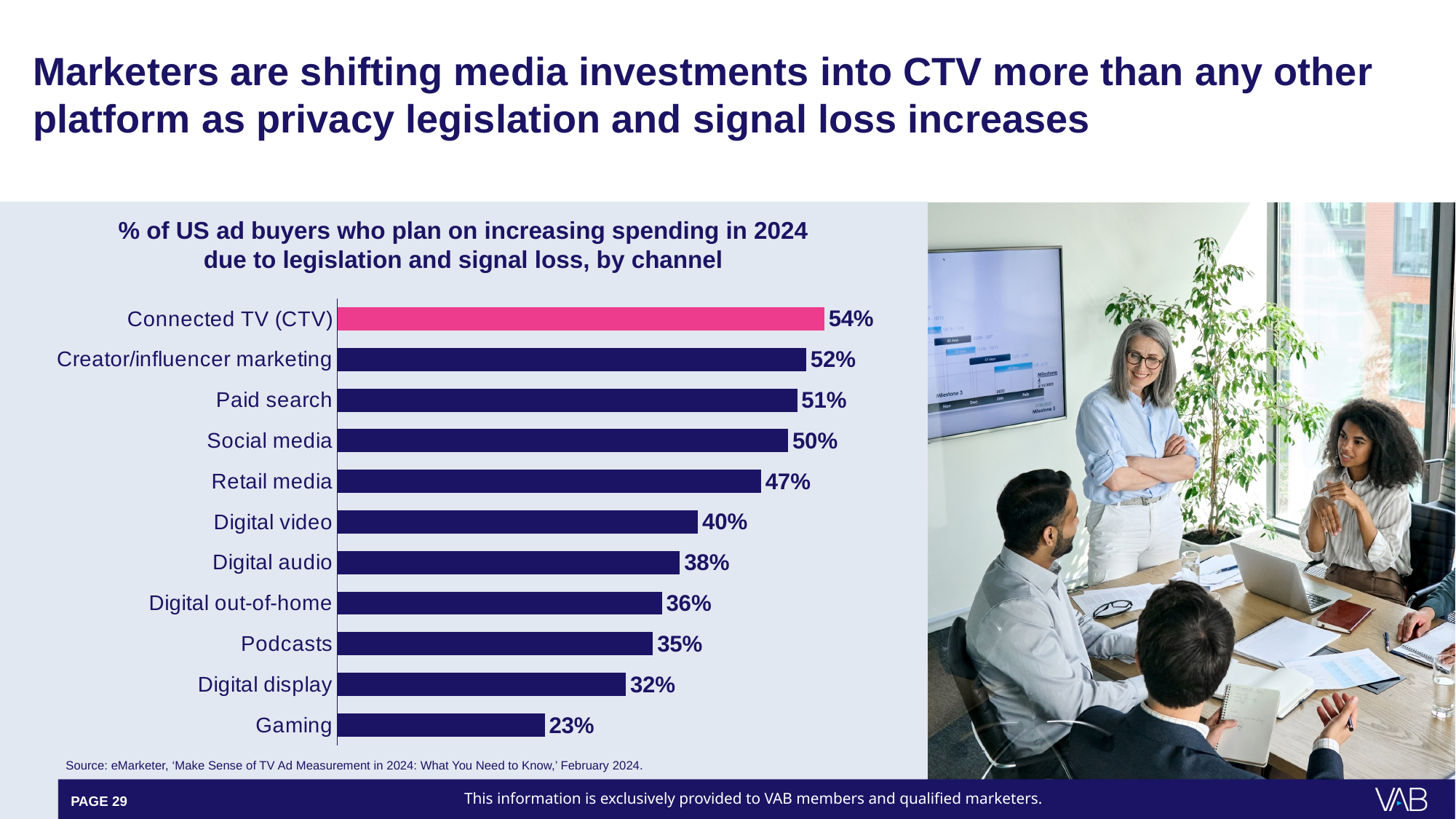
Which has a higher value, Digital audio or Digital out-of-home? Digital audio What is the difference between the values for Connected TV (CTV) and Gaming? 31% How many channels are shown in the chart? 11 What is the difference between the values for Digital video and Digital display? 8% What kind of chart is shown on the slide? Bar chart What is the value shown for Podcasts? 35% Which bar in the chart is highlighted in a different colour (pink) from the others? Connected TV (CTV) Which channel has the lowest percentage of ad buyers planning to increase spending? Gaming Which channel has the highest percentage of ad buyers planning to increase spending? Connected TV (CTV) Which has a higher value, Paid search or Social media? Paid search What is the value shown for Retail media? 47% What percentage of US ad buyers plan on increasing spending on Connected TV (CTV) in 2024? 54%